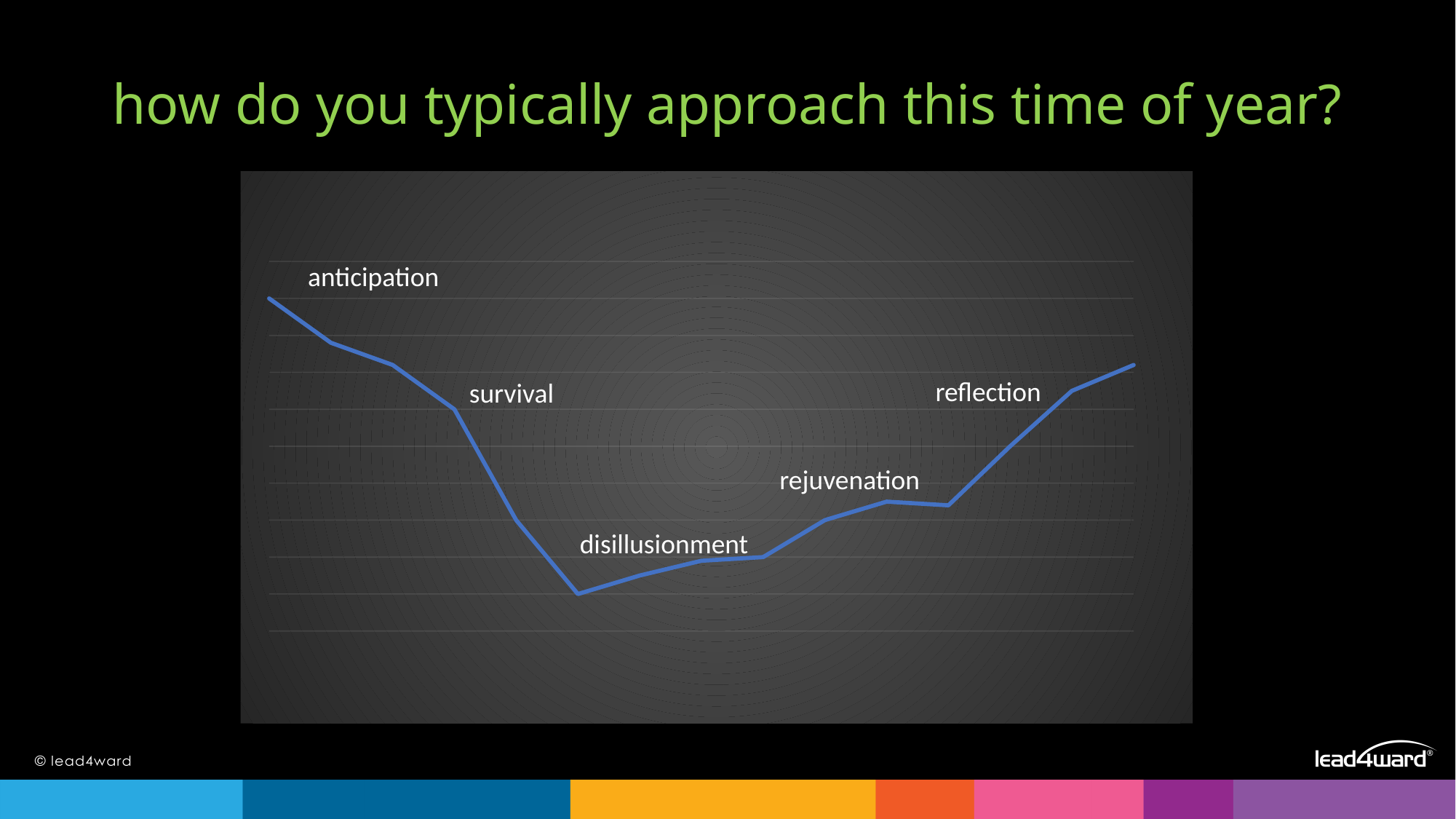
Is the line higher at survival or at rejuvenation? survival What is the title of the slide above the chart? how do you typically approach this time of year? Does the line rise or fall from disillusionment to reflection? rise Which labeled phase is at the lowest point of the line? disillusionment How many lines are plotted on the chart? 1 Is the line higher at anticipation or at reflection? anticipation Does the line rise or fall from anticipation to disillusionment? fall How many labeled phases are marked along the line? 5 Which labeled phase is at the highest point of the line? anticipation Which labeled phase appears last along the x axis? reflection What kind of chart is shown on the slide? line chart Which labeled phase appears first along the x axis? anticipation